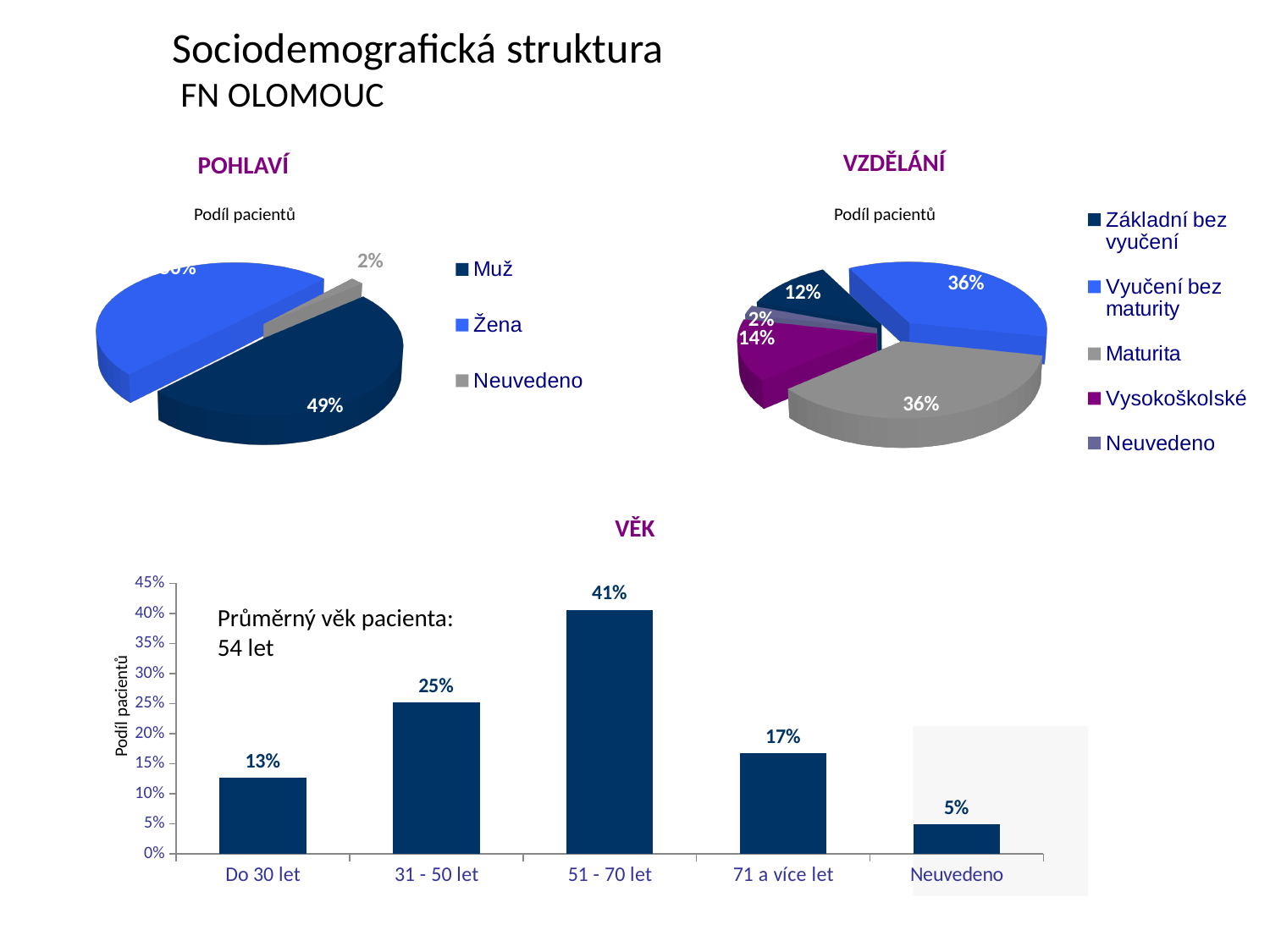
How many legend entries does the POHLAVÍ pie chart list? 3 In the POHLAVÍ pie chart, what share of patients are Muž? 49% In the VĚK chart, what is the share of patients aged 71 a více let? 17% In the VZDĚLÁNÍ pie chart, what share of patients have Základní bez vyučení? 12% In the POHLAVÍ pie chart, what share of patients is Neuvedeno? 2% How many categories does the VZDĚLÁNÍ pie chart legend list? 5 What type of chart is the VĚK chart? bar chart In the VZDĚLÁNÍ pie chart, which category has the smallest share? Neuvedeno How many age categories are shown in the VĚK bar chart? 5 In the VZDĚLÁNÍ pie chart, what share of patients have Vysokoškolské education? 14% In the VĚK chart, what is the difference between the shares for 51 - 70 let and 31 - 50 let? 16 percentage points In the VĚK chart, which age group has the highest share of patients? 51 - 70 let